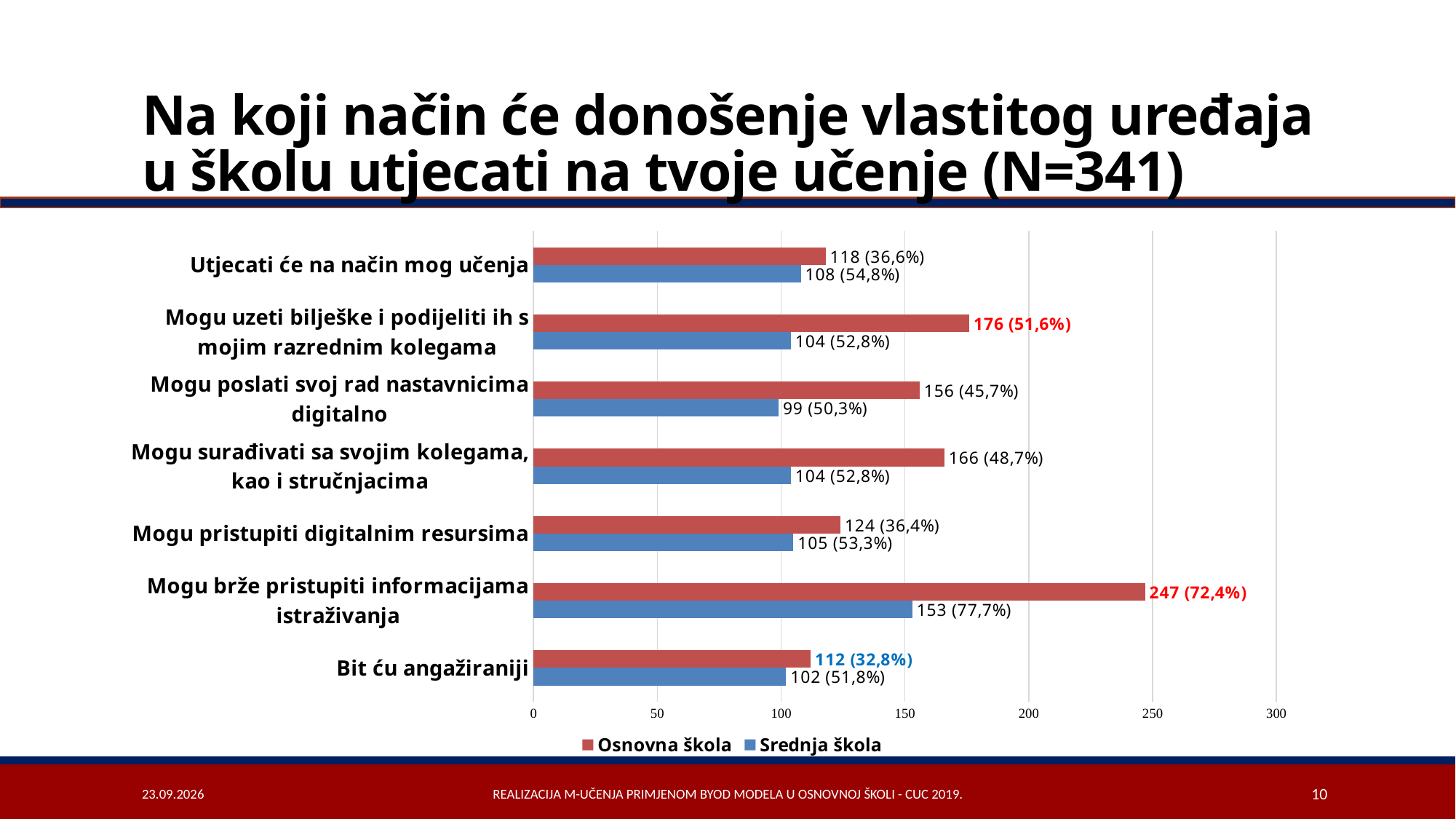
What is the value for Osnovna škola for "Mogu brže pristupiti informacijama istraživanja"? 247 (72,4%) How many series does the legend list? 2 Which is larger for "Mogu pristupiti digitalnim resursima": the Osnovna škola count or the Srednja škola count? Osnovna škola What is the value for Srednja škola for "Utjecati će na način mog učenja"? 108 (54,8%) What is the difference in count between Osnovna škola and Srednja škola for "Mogu uzeti bilješke i podijeliti ih s mojim razrednim kolegama"? 72 Which colour represents Srednja škola in the chart? blue What kind of chart is shown on the slide? bar chart Which category has the highest value for Osnovna škola? Mogu brže pristupiti informacijama istraživanja Which category has the lowest value for Srednja škola? Mogu poslati svoj rad nastavnicima digitalno What is the value for Osnovna škola for "Bit ću angažiraniji"? 112 (32,8%) How many categories are shown on the chart? 7 Is the Osnovna škola value for "Mogu surađivati sa svojim kolegama, kao i stručnjacima" greater or less than 150? greater